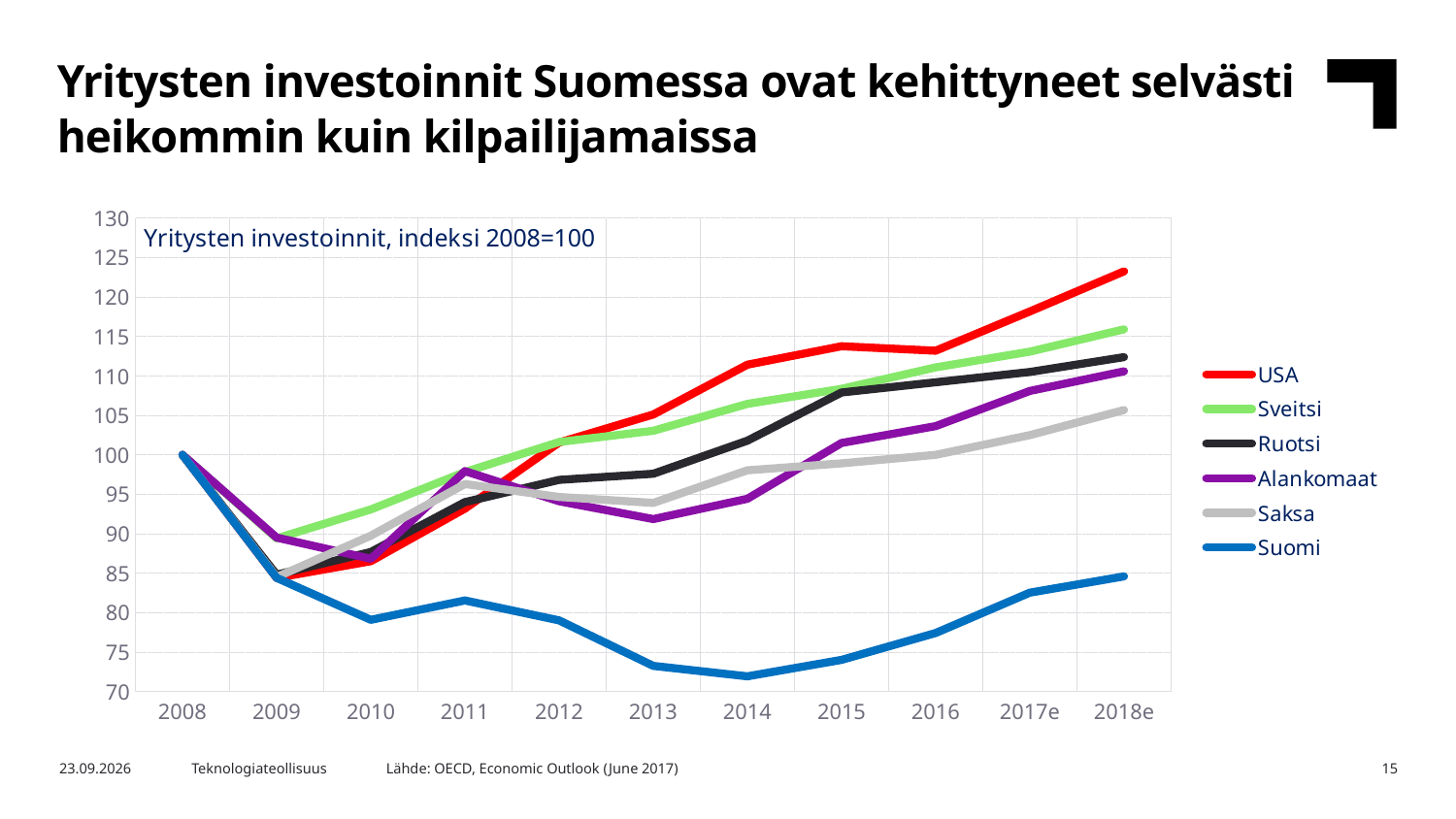
How many years are shown on the x axis? 11 Which country has the highest index value in 2018e? USA What is the index value for Suomi in 2008? 100 In 2018e, which is higher: Sveitsi or Ruotsi? Sveitsi Does the Suomi line rise or fall from 2014 to 2018e? rise Which country has the lowest index value in 2010? Suomi Which country has the lowest index value in 2018e? Suomi What kind of chart is shown on the slide? line chart How many series does the legend list? 6 Is the value for USA in 2018e greater or less than 120? greater Is the value for Suomi in 2014 greater or less than 75? less Is the value for Alankomaat in 2013 greater or less than 95? less